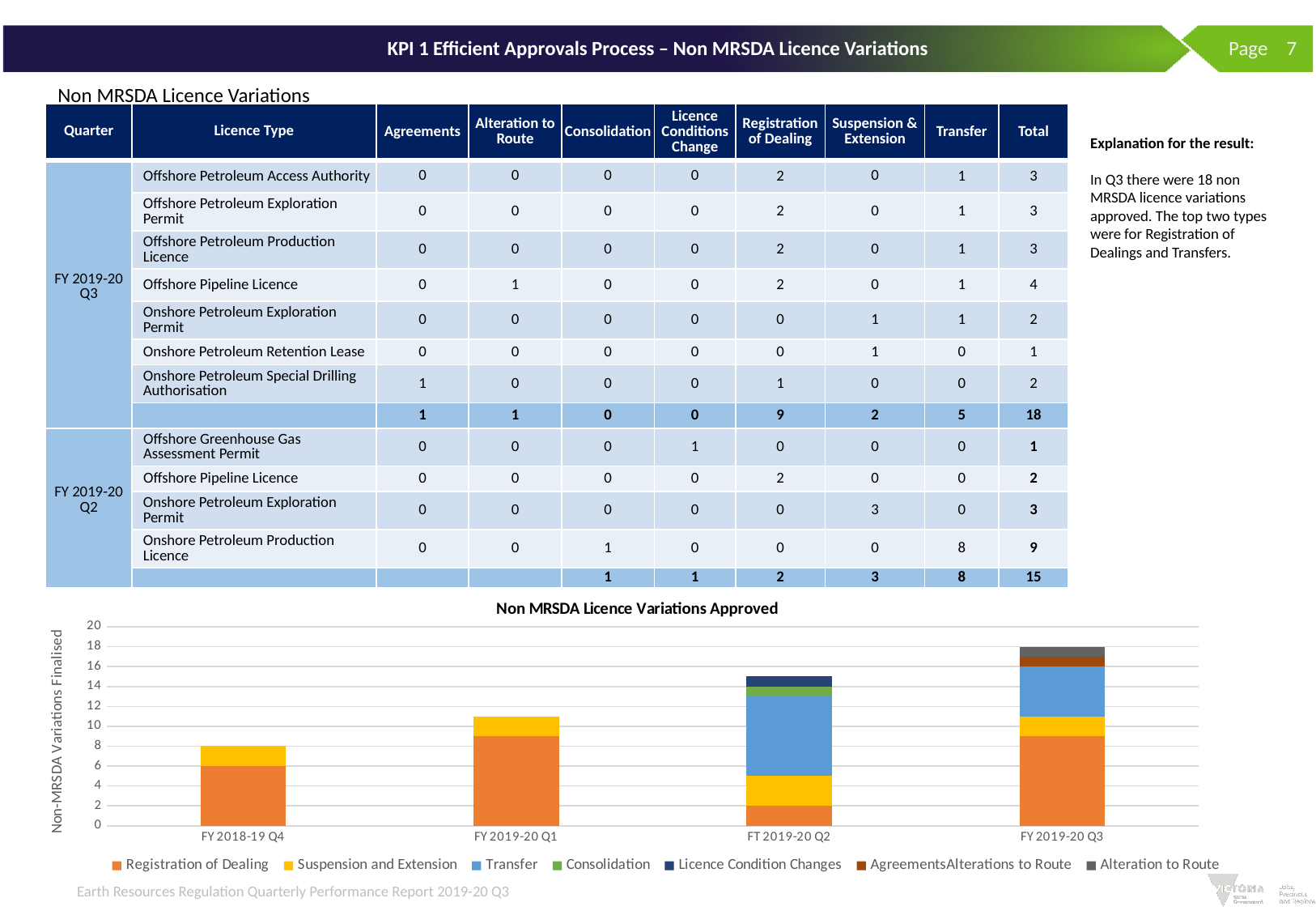
Do the stacked bar totals rise or fall from FY 2018-19 Q4 to FY 2019-20 Q3? Rise Is the total for FY 2019-20 Q1 greater or less than 12? less What is the title of the chart? Non MRSDA Licence Variations Approved Is the total for FT 2019-20 Q2 greater or less than 12? greater Which bar is taller, FY 2019-20 Q3 or FY 2018-19 Q4? FY 2019-20 Q3 What is the total height of the stacked bar for FY 2019-20 Q3? 18 What kind of chart is shown on the slide? Stacked bar chart How many series does the chart legend list? 7 How many quarters are plotted along the x axis of the chart? 4 Which quarter has the shortest stacked bar in the chart? FY 2018-19 Q4 Which quarter has the tallest stacked bar in the chart? FY 2019-20 Q3 What is the total height of the stacked bar for FY 2018-19 Q4? 8